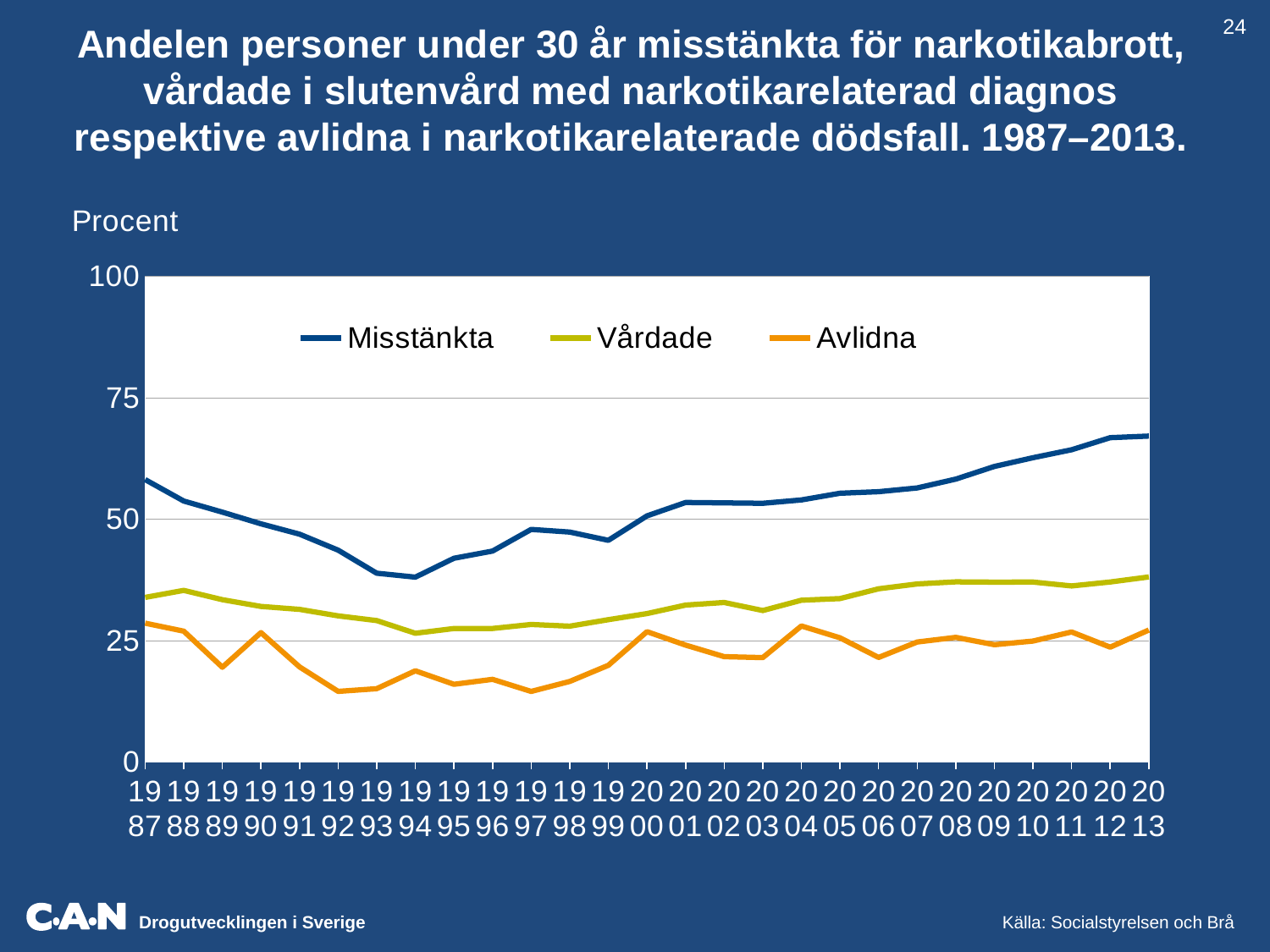
How many years are plotted along the x axis? 27 Is the value for Avlidna in 1992 greater or less than 25? less What label is shown above the y axis of the chart? Procent Is the value for Vårdade in 1987 greater or less than 25? greater Is the value for Misstänkta in 1994 greater or less than 50? less What kind of chart is shown on the slide? Line chart In which year does the Misstänkta series reach its highest value? 2013 Which series has the larger value in 2013, Misstänkta or Avlidna? Misstänkta How many series does the legend list? 3 Which series has the larger value in 1995, Vårdade or Avlidna? Vårdade Does the Misstänkta series rise or fall between 2003 and 2013? Rise